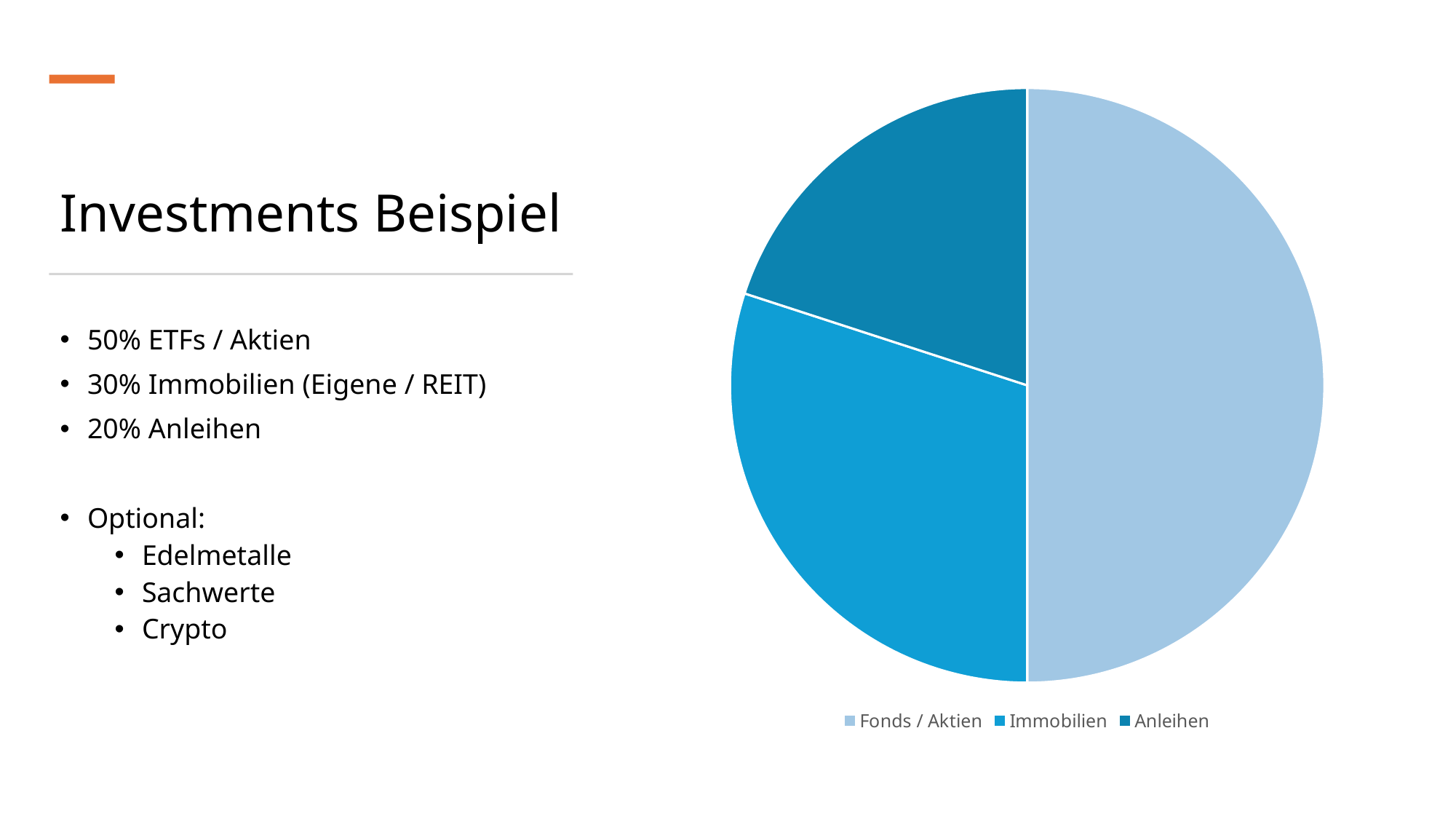
Which slice is larger in the pie chart, Immobilien or Anleihen? Immobilien What share of the pie does the Immobilien slice represent, according to the slide? 30% Which legend entry is shown in the lightest blue colour? Fonds / Aktien How many entries does the legend of the pie chart list? 3 Which slice is larger in the pie chart, Fonds / Aktien or Immobilien? Fonds / Aktien What share of the pie does the Anleihen slice represent, according to the slide? 20% Where is the legend positioned relative to the pie chart? below the chart Which category has the largest slice in the pie chart? Fonds / Aktien Which category has the smallest slice in the pie chart? Anleihen How many slices does the pie chart have? 3 What kind of chart is shown on the slide? pie chart What share of the pie does the Fonds / Aktien slice represent, according to the slide? 50%